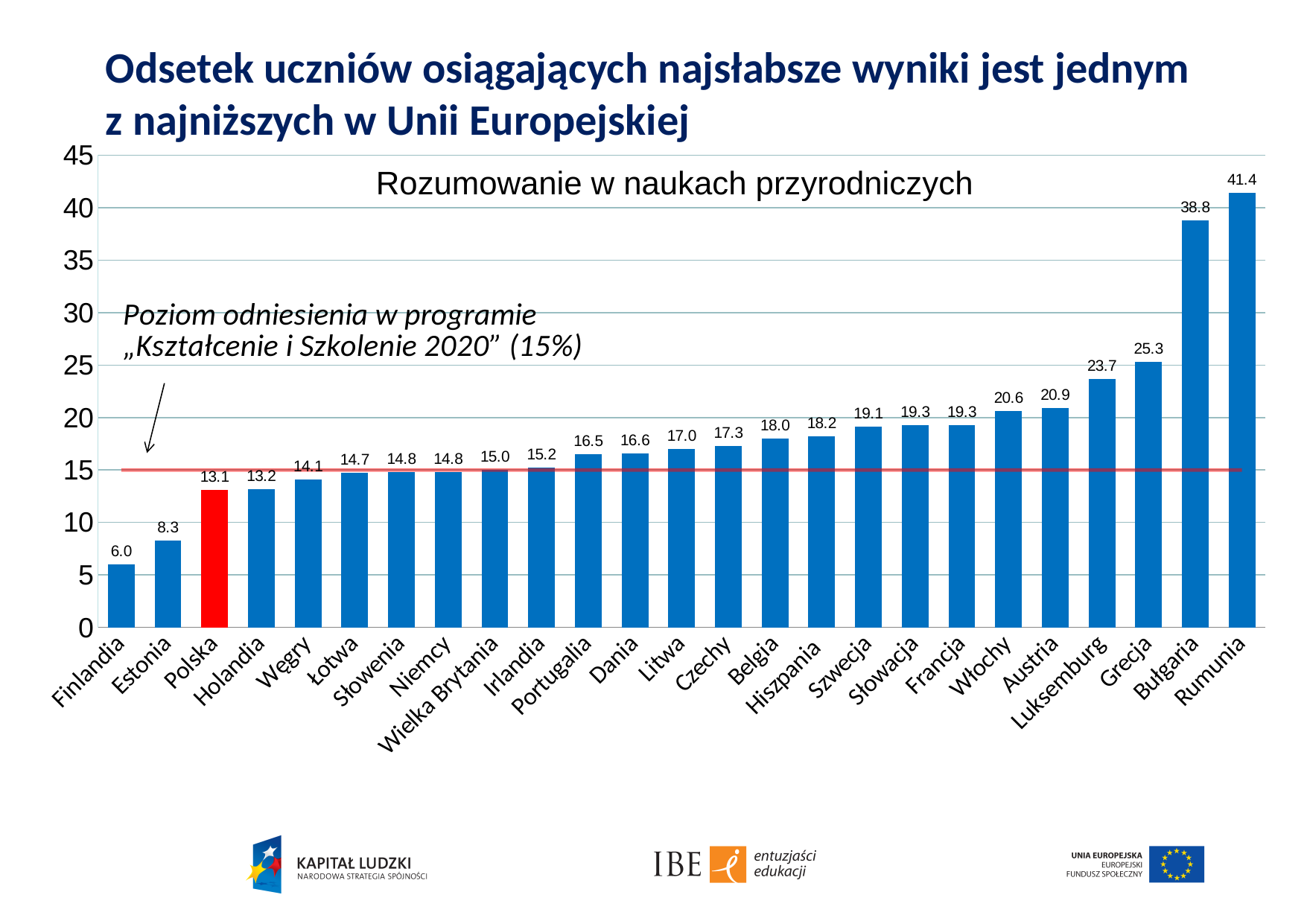
Which country has the lowest value? Finlandia Which is larger, the value for Austria or the value for Włochy? Austria Is the value for Luksemburg greater or less than 20? greater What is the value for Polska? 13.1 Which country's bar is coloured red? Polska What kind of chart is shown on the slide? bar chart What is the difference between the values for Polska and Finlandia? 7.1 How many countries are shown on the chart? 25 What is the value for Wielka Brytania? 15.0 What is the value for Grecja? 25.3 What is the difference between the values for Rumunia and Bułgaria? 2.6 Which country has the highest value? Rumunia